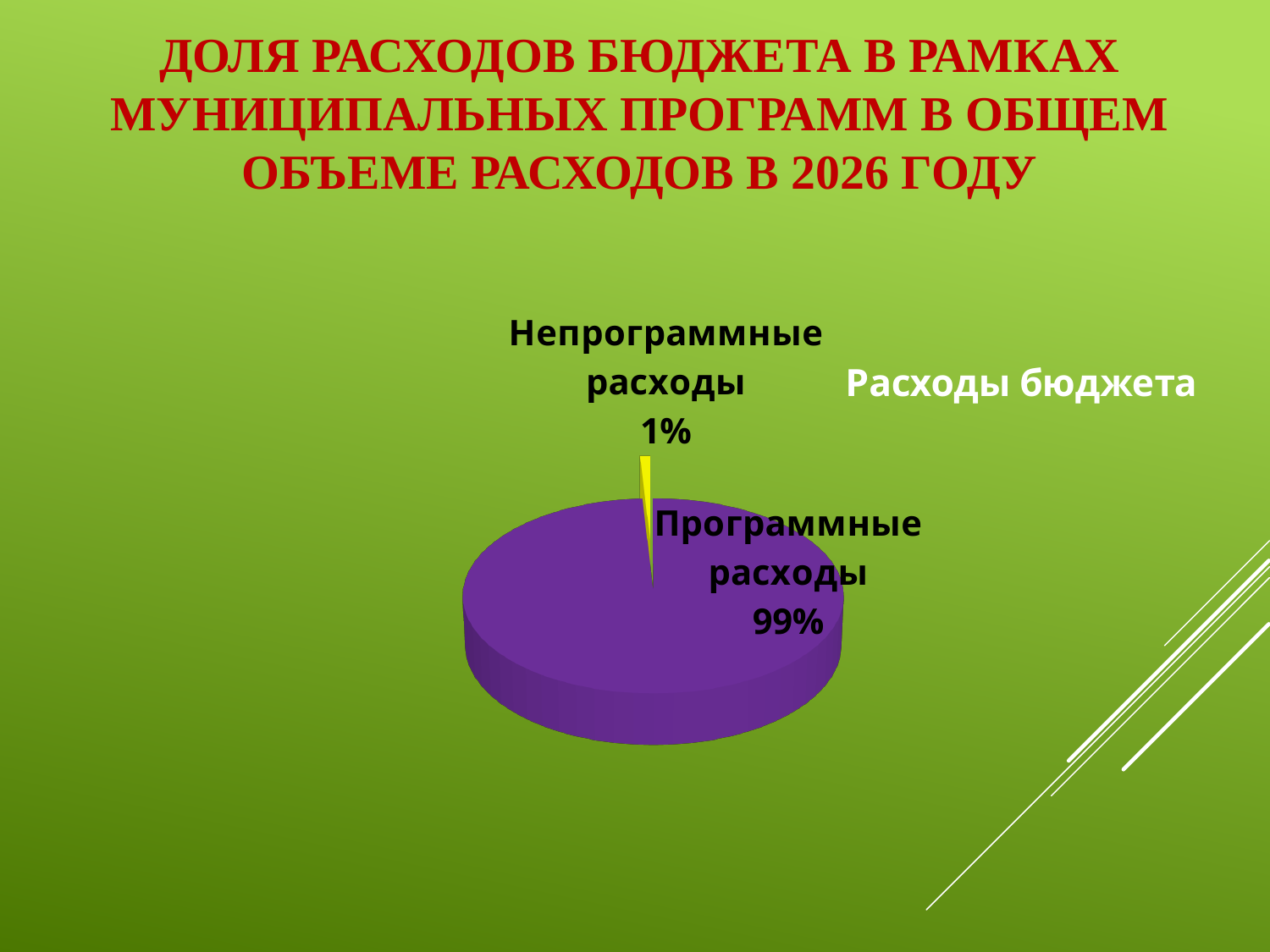
What is the chart's title? Расходы бюджета What is the difference between the shares of Программные расходы and Непрограммные расходы? 98% What share of the pie is Программные расходы? 99% Which is larger: Программные расходы or Непрограммные расходы? Программные расходы What kind of chart is shown on the slide? Pie chart Which slice of the pie is the smallest? Непрограммные расходы Which slice of the pie is the largest? Программные расходы What colour is the Программные расходы slice? Purple What share of the pie is Непрограммные расходы? 1% How many slices does the pie chart have? 2